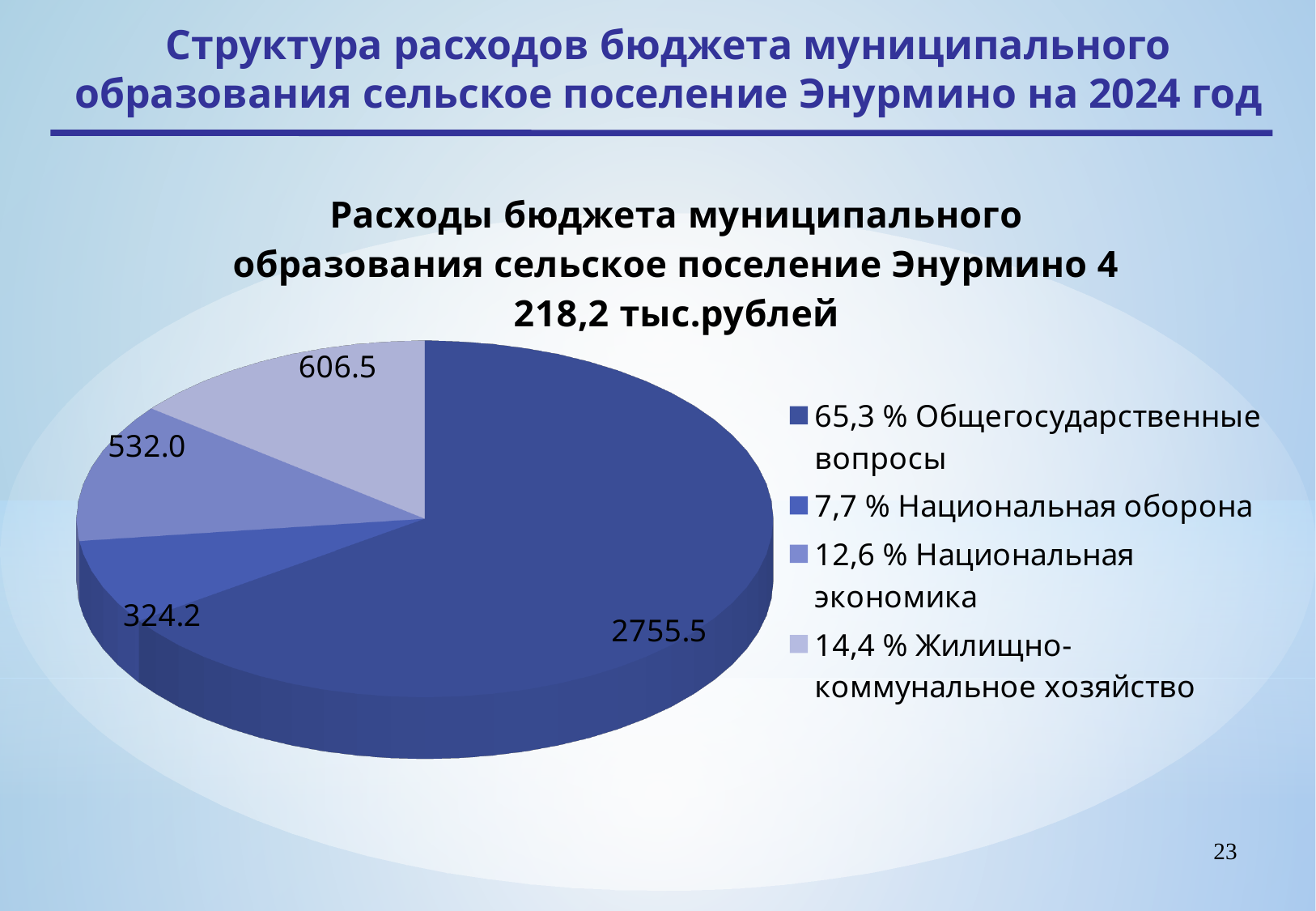
What kind of chart is shown on the slide? Pie chart Which category has the smallest slice of the pie? Национальная оборона What is the value for Национальная оборона? 324.2 What is the value for Жилищно-коммунальное хозяйство? 606.5 What is the value for Общегосударственные вопросы? 2755.5 What is the difference between the values for Жилищно-коммунальное хозяйство and Национальная экономика? 74.5 How many slices does the pie chart have? 4 What is the value for Национальная экономика? 532.0 Which is larger: the value for Жилищно-коммунальное хозяйство or the value for Национальная оборона? Жилищно-коммунальное хозяйство What share of the pie does Национальная экономика represent, according to the legend? 12,6 % What total amount in thousand rubles is stated in the chart title? 4 218,2 тыс.рублей Which category has the largest slice of the pie? Общегосударственные вопросы